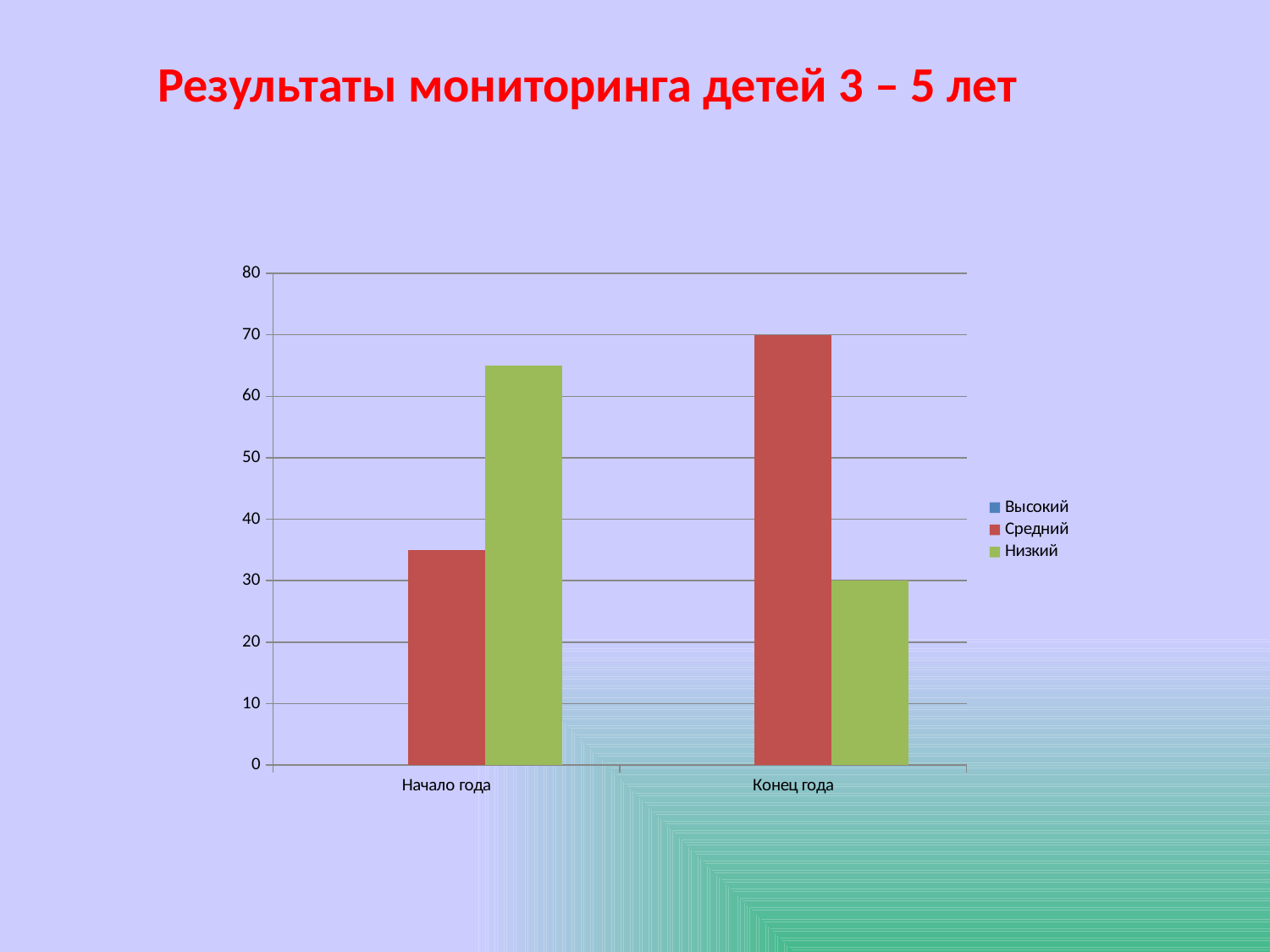
Which series has the highest value in Начало года? Низкий Is the value for Низкий in Начало года greater or less than 60? greater How many categories are shown on the x axis? 2 Does the value for Низкий rise or fall from Начало года to Конец года? fall What is the value for Средний in Конец года? 70 Which series has the highest value in Конец года? Средний What is the value for Низкий in Конец года? 30 Which is larger: Средний in Конец года or Низкий in Конец года? Средний in Конец года What is the title of the slide? Результаты мониторинга детей 3 – 5 лет How many series does the legend list? 3 Is the value for Средний in Начало года greater or less than 40? less What kind of chart is shown on the slide? bar chart